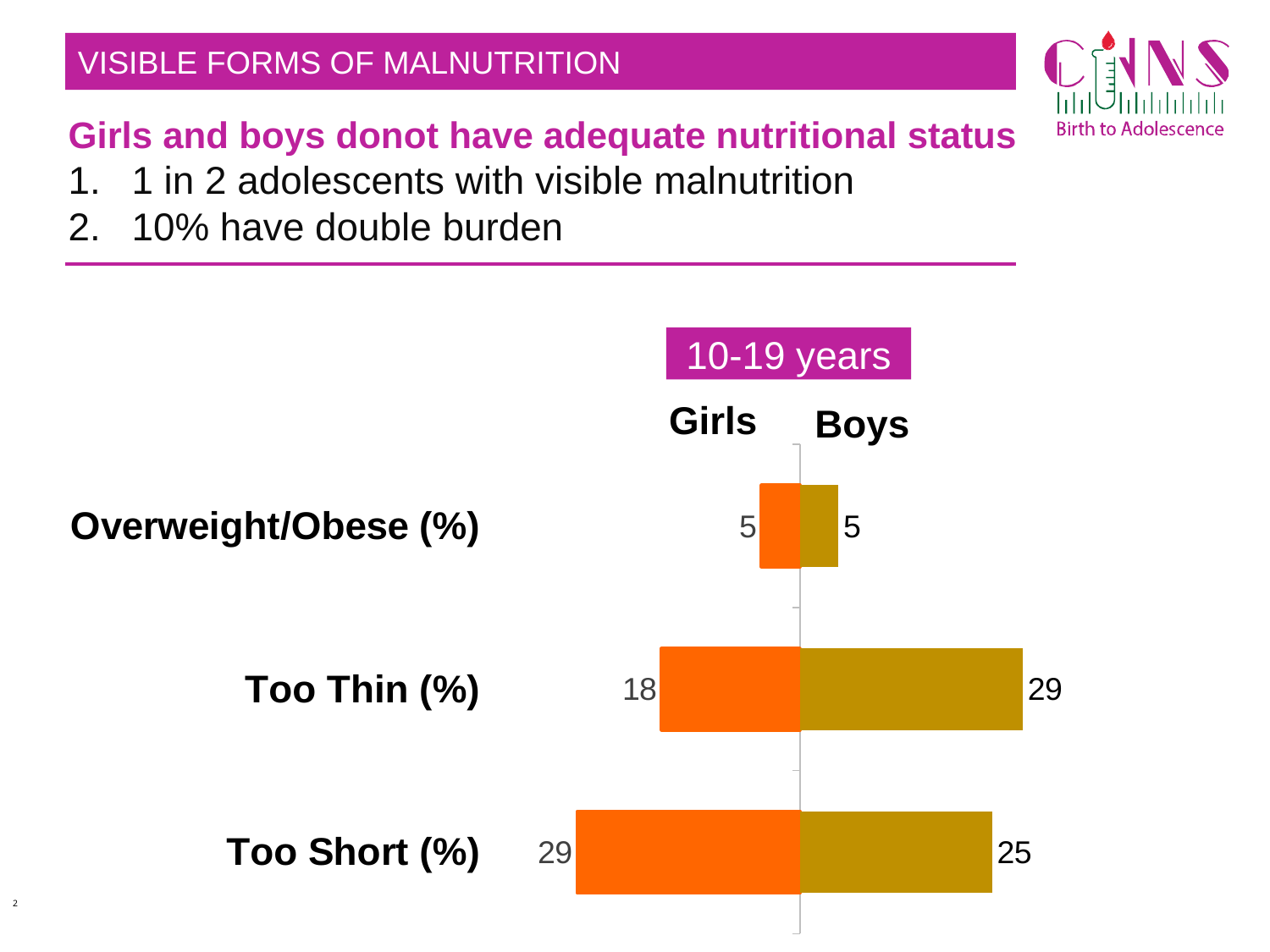
What is the difference between the Boys and Girls values for Too Thin (%)? 11 What is the Too Short (%) value for Boys? 25 What is the Too Thin (%) value for Boys? 29 What is the Too Thin (%) value for Girls? 18 What age group does the chart cover, according to the label above it? 10-19 years What is the Too Short (%) value for Girls? 29 Which category has the highest value for Boys? Too Thin (%) Which is larger for Too Short (%), the Girls value or the Boys value? Girls How many categories are shown in the chart? 3 What kind of chart is shown on the slide? Bar chart Which category has the lowest value for Girls? Overweight/Obese (%) What is the Overweight/Obese (%) value for Boys? 5